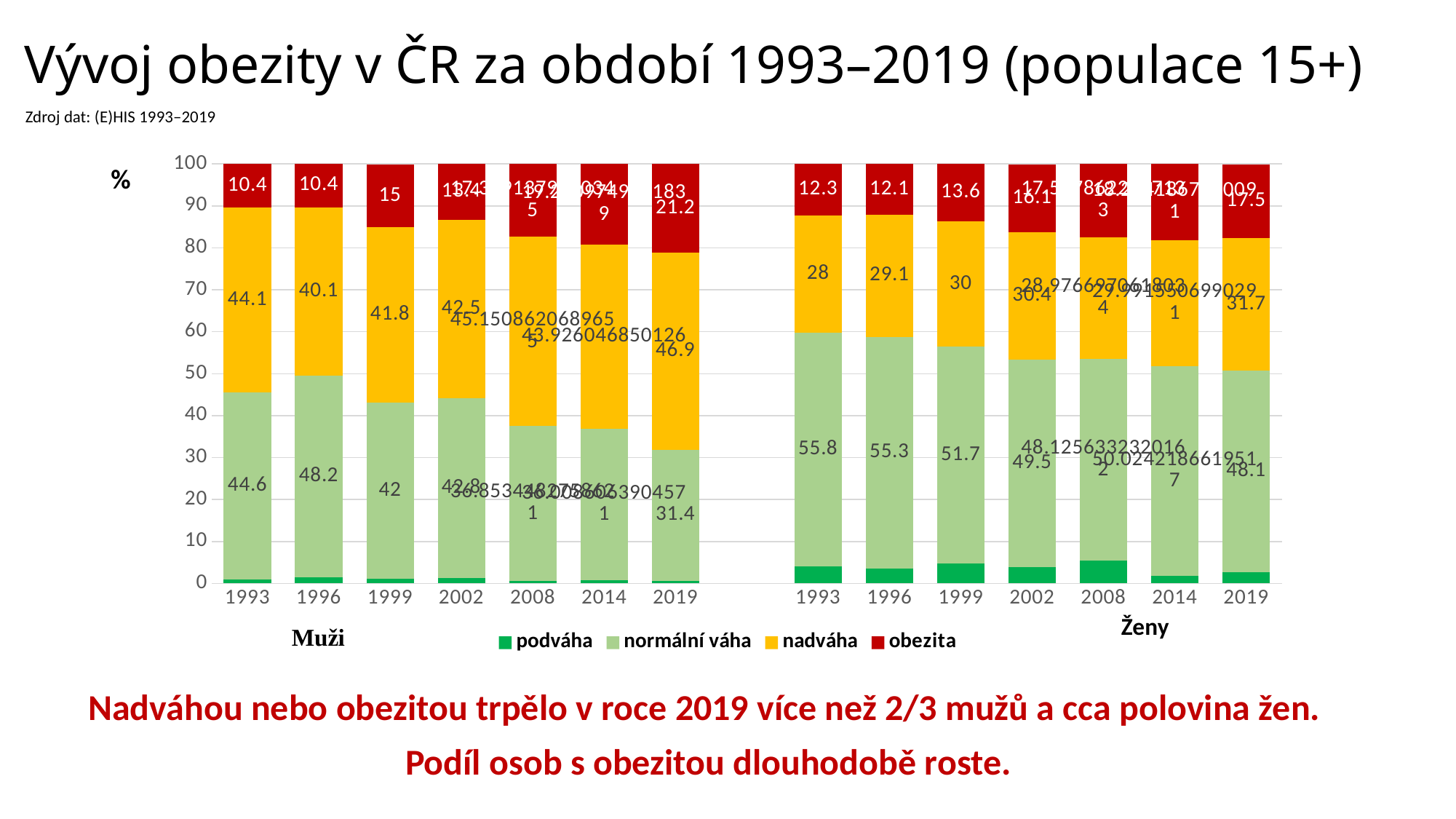
How many series does the legend list? 4 How many years are shown for the Muži group? 7 What is the nadváha value for Ženy in 2019? 31.7 Does the obezita value for Ženy rise or fall from 1993 to 2019? rise What is the obezita value for Muži in 1993? 10.4 What is the nadváha value for Muži in 1999? 41.8 What is the normální váha value for Ženy in 1993? 55.8 What kind of chart is shown on the slide? stacked bar chart Is the podváha value for Ženy in 2008 greater or less than 10? less By how much did the obezita value for Muži increase from 1993 to 2019? 10.8 In 2019, which group has the higher obezita value, Muži or Ženy? Muži What is the obezita value for Muži in 2019? 21.2